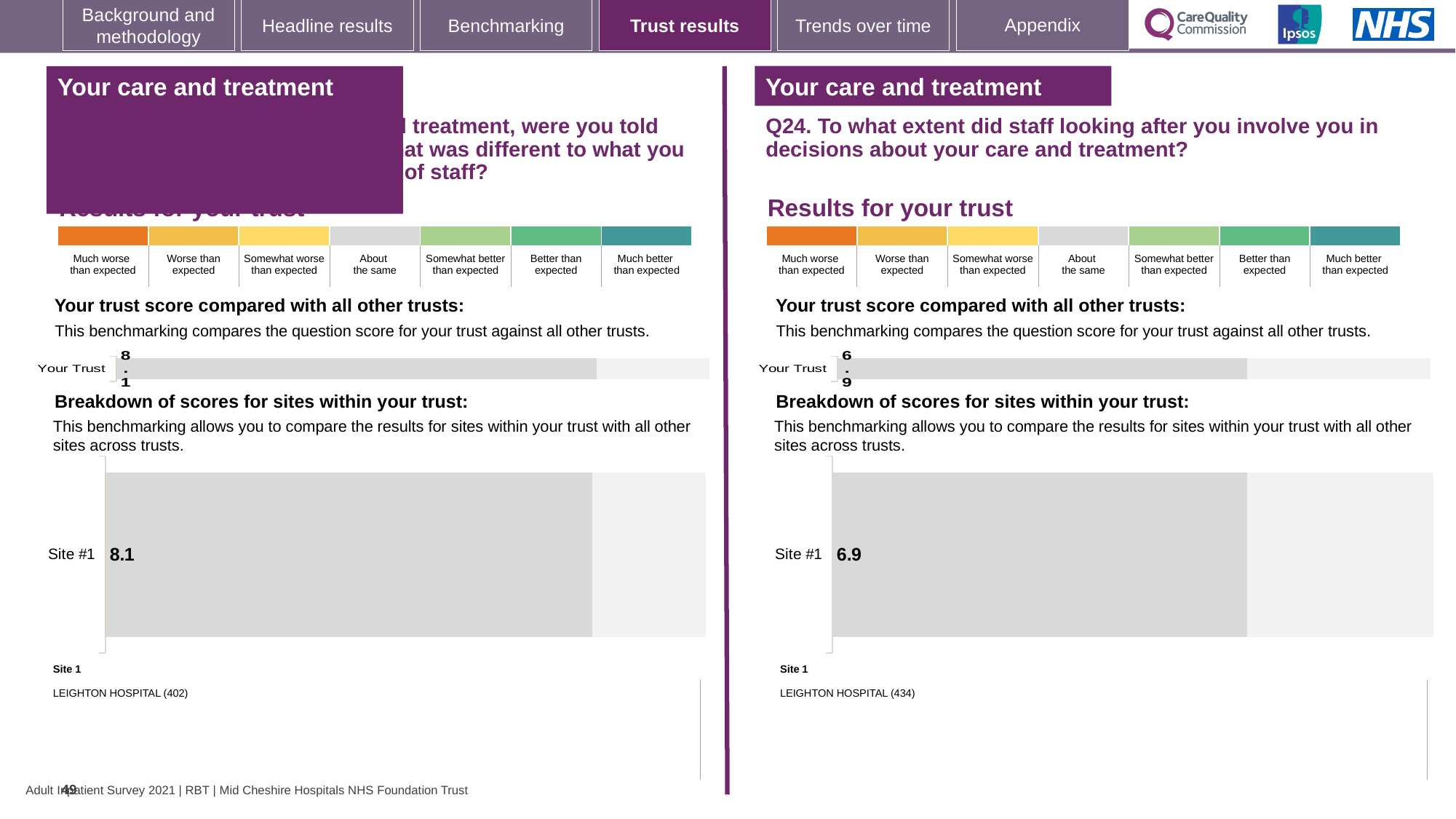
On the left panel's 'Breakdown of scores for sites within your trust' chart, what is the score for Site #1? 8.1 On the right panel (Q24) 'Breakdown of scores for sites within your trust' chart, what is the score for Site #1? 6.9 How many sites are shown in the left panel's 'Breakdown of scores for sites within your trust' chart? 1 On the left panel, which hospital is listed as Site 1 below the site breakdown chart? LEIGHTON HOSPITAL (402) On the right panel (Q24), is the Site #1 score equal to the Your Trust score? Yes, both are 6.9 Comparing the Your Trust scores on the left and right panels, which is larger? Left panel (8.1) On the right panel (Q24) 'Your trust score compared with all other trusts' chart, what is the score for Your Trust? 6.9 On the right panel (Q24), which hospital is listed as Site 1 below the site breakdown chart? LEIGHTON HOSPITAL (434) How many sites are shown in the right panel's (Q24) 'Breakdown of scores for sites within your trust' chart? 1 On the left panel's 'Your trust score compared with all other trusts' chart, what is the score for Your Trust? 8.1 What kind of chart is used for the 'Breakdown of scores for sites within your trust' on the right panel (Q24)? Bar chart What is the difference between the Your Trust score on the left panel (8.1) and the Your Trust score on the right panel (6.9)? 1.2